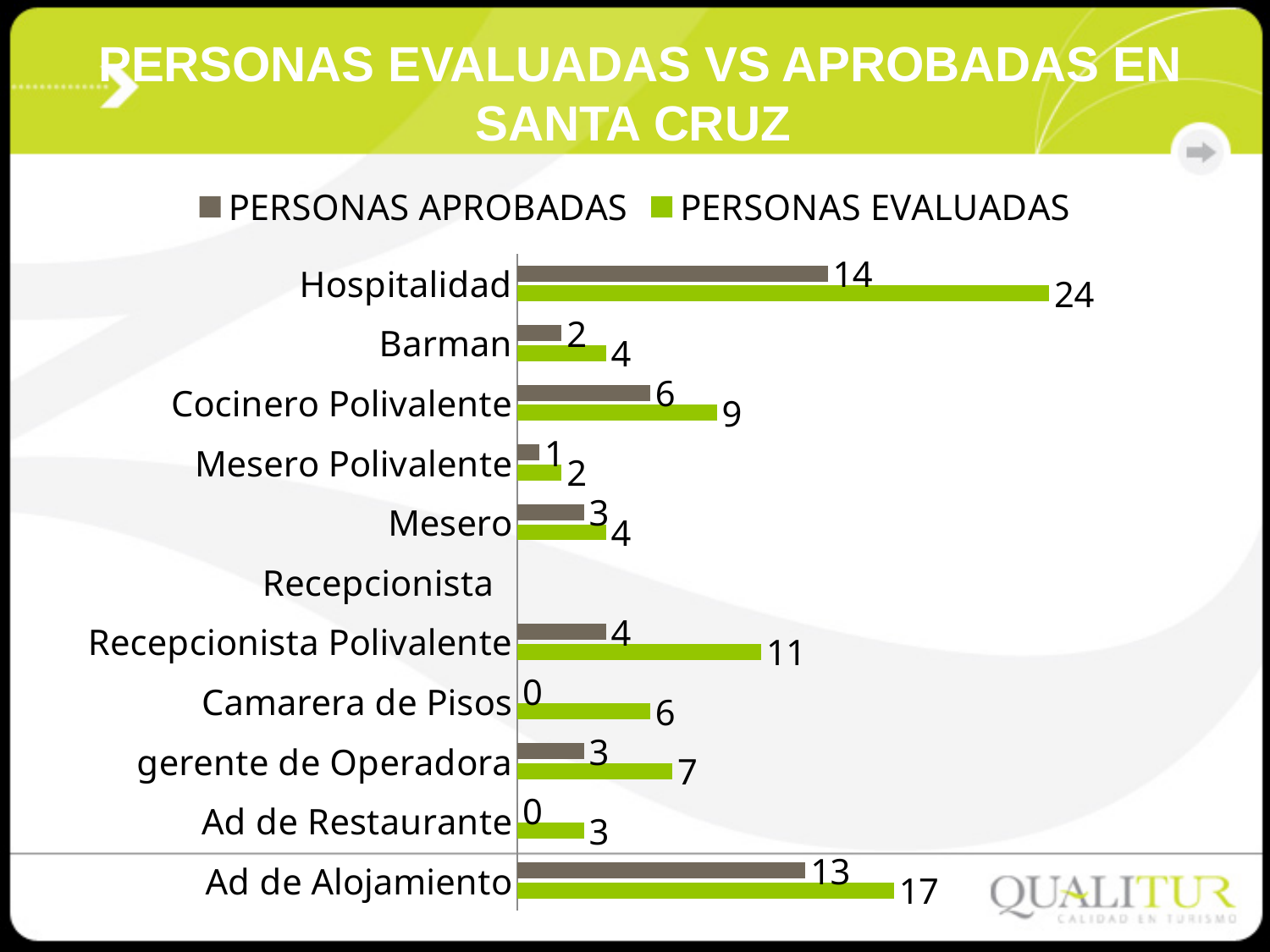
How many PERSONAS APROBADAS are shown for Ad de Alojamiento? 13 What is the value of PERSONAS EVALUADAS for Recepcionista Polivalente? 11 How many PERSONAS EVALUADAS are shown for Hospitalidad? 24 What is the difference between PERSONAS EVALUADAS and PERSONAS APROBADAS for Recepcionista Polivalente? 7 What colour represents PERSONAS EVALUADAS in the legend? green Which is larger: PERSONAS EVALUADAS for Cocinero Polivalente or PERSONAS EVALUADAS for gerente de Operadora? Cocinero Polivalente How many PERSONAS APROBADAS are shown for Camarera de Pisos? 0 How many series does the legend list? 2 What is the difference between PERSONAS EVALUADAS and PERSONAS APROBADAS for Hospitalidad? 10 How many categories are listed on the vertical axis of the chart? 11 Which category has the highest number of PERSONAS EVALUADAS? Hospitalidad What type of chart is shown on the slide? bar chart